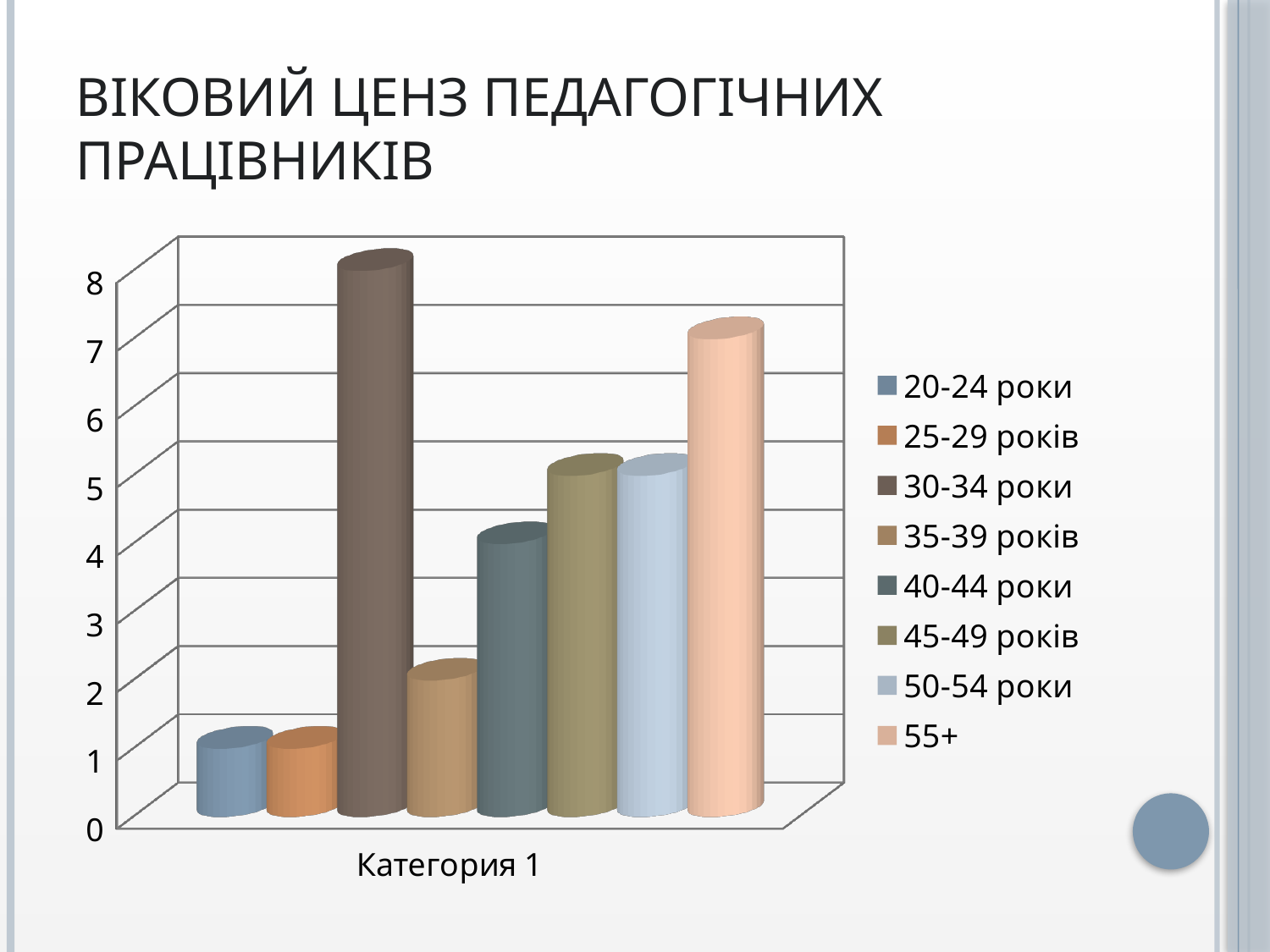
Which is larger, the value for 35-39 років or the value for 55+? 55+ Which is larger, the value for 40-44 роки or the value for 45-49 років? 45-49 років Is the value for 40-44 роки greater or less than 5? less Is the value for 55+ greater or less than 6? greater Which age group has the highest bar? 30-34 роки How many series does the legend list? 8 Which is larger, the value for 30-34 роки or the value for 55+? 30-34 роки What is the title of the slide containing the chart? Віковий ценз педагогічних працівників Is the value for 30-34 роки greater or less than 7? greater What kind of chart is shown on the slide? bar chart